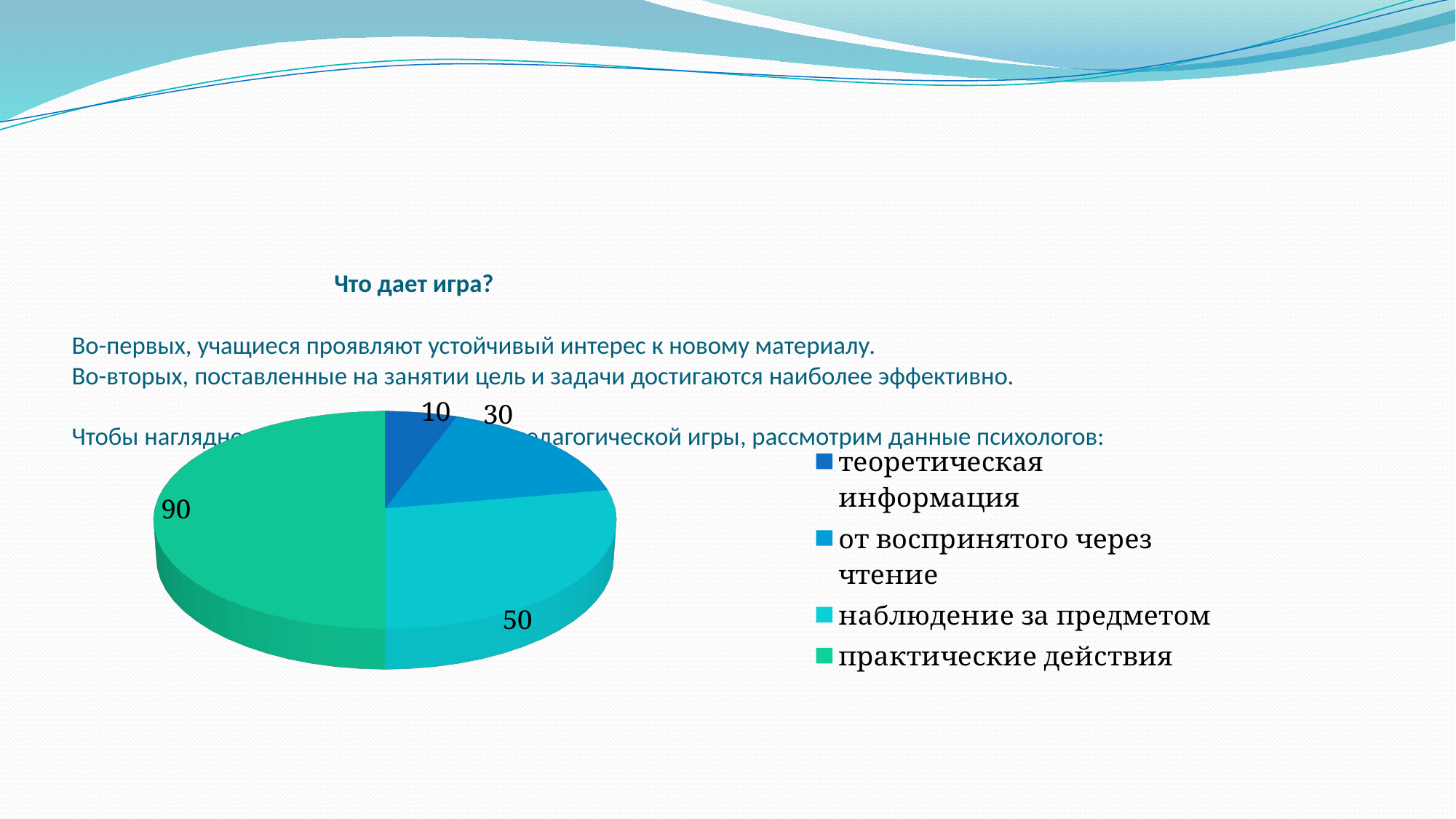
What kind of chart is shown on the slide? pie chart What is the value for теоретическая информация? 10 Which category has the smallest slice of the pie? теоретическая информация Which is larger, the value for от воспринятого через чтение or the value for наблюдение за предметом? наблюдение за предметом What is the value for от воспринятого через чтение? 30 What is the difference between the values for практические действия and наблюдение за предметом? 40 What share of the pie does практические действия represent? 50% What is the value for практические действия? 90 How many slices does the pie chart have? 4 What colour is the slice for практические действия? green What is the value for наблюдение за предметом? 50 Which category has the largest slice of the pie? практические действия